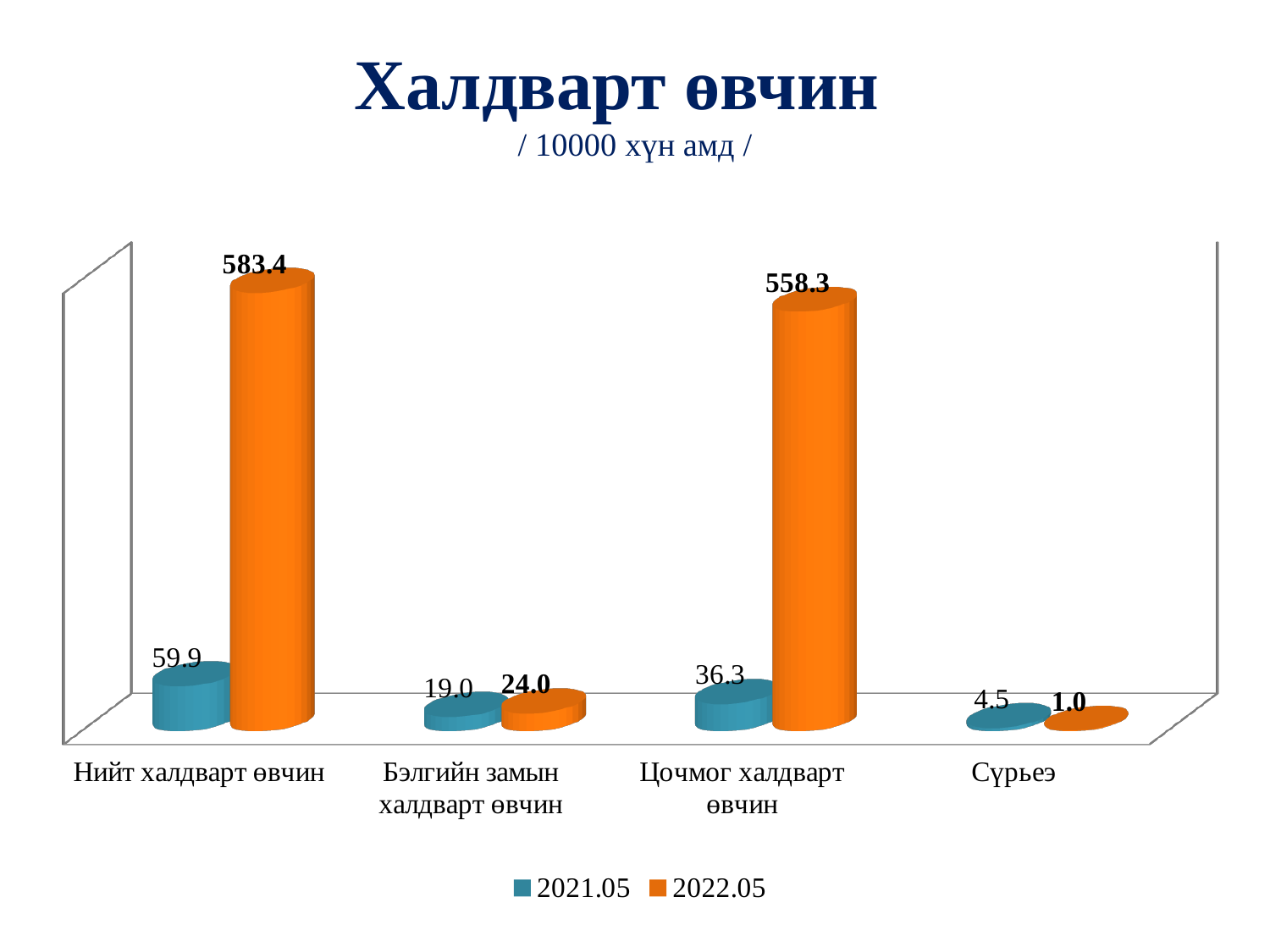
What is the value for Бэлгийн замын халдварт өвчин in the 2021.05 series? 19.0 What is the difference between the 2022.05 and 2021.05 values for Бэлгийн замын халдварт өвчин? 5.0 How many series does the legend list? 2 What is the value for Сүрьеэ in the 2022.05 series? 1.0 Which category has the highest value in the 2022.05 series? Нийт халдварт өвчин What kind of chart is shown on the slide? Bar chart How many categories are shown on the x axis? 4 Which category has the lowest value in the 2021.05 series? Сүрьеэ What is the value for Нийт халдварт өвчин in the 2022.05 series? 583.4 What is the value for Цочмог халдварт өвчин in the 2021.05 series? 36.3 For Сүрьеэ, which series has the larger value, 2021.05 or 2022.05? 2021.05 What is the difference between the 2022.05 and 2021.05 values for Нийт халдварт өвчин? 523.5